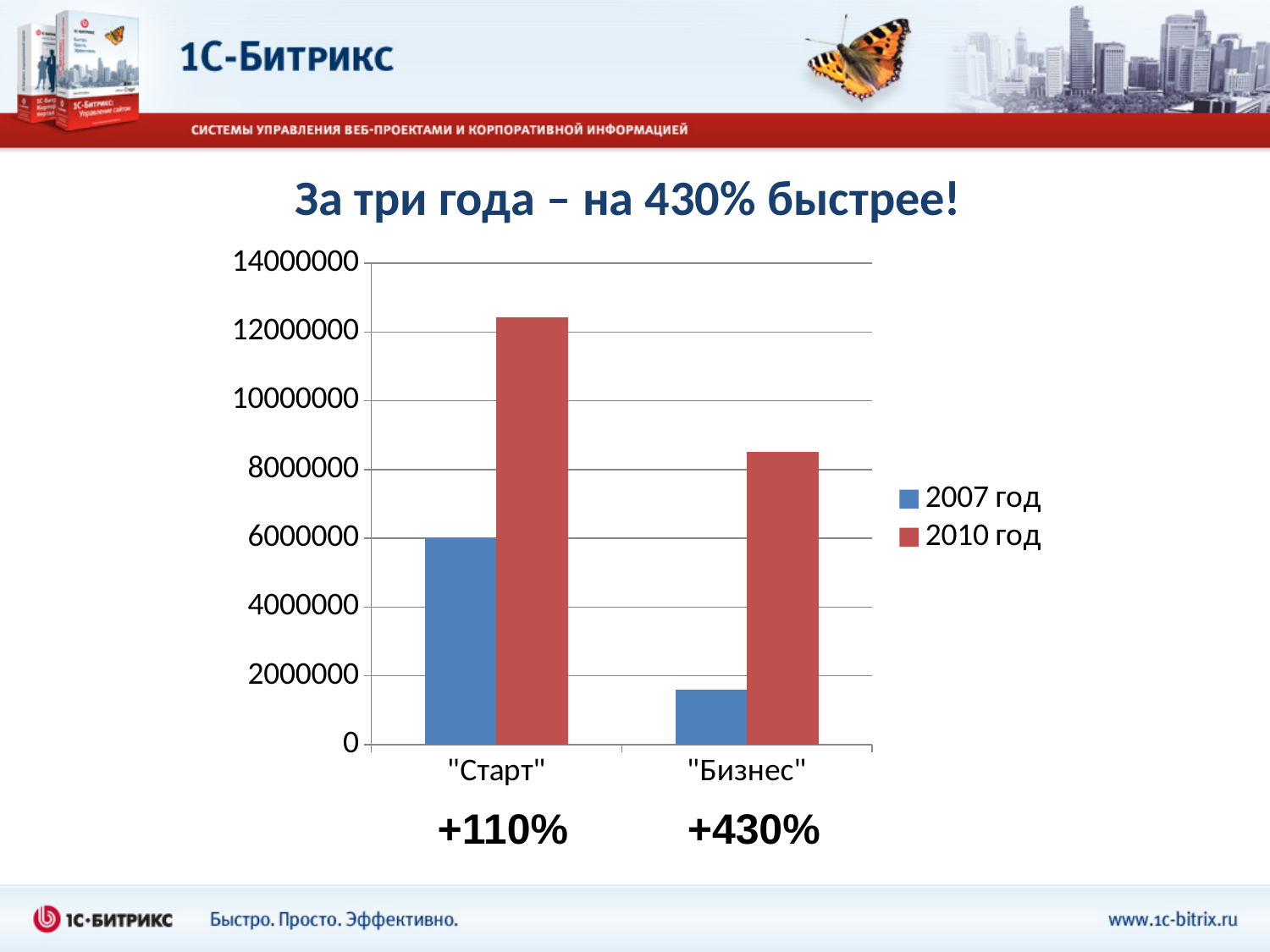
Is the 2007 год value for "Бизнес" greater or less than 2000000? less What is the title of the chart on the slide? За три года – на 430% быстрее! How many series does the legend list? 2 How many categories are shown on the x axis? 2 Which category has the lowest 2007 год bar? "Бизнес" Is the 2010 год value for "Бизнес" greater or less than 8000000? greater What kind of chart is shown on the slide? bar chart Which series does the red colour represent in the legend? 2010 год Which category has the highest 2010 год bar? "Старт" For "Бизнес", which is larger: the 2007 год bar or the 2010 год bar? 2010 год What percentage growth is printed under the "Бизнес" category? +430% Is the 2010 год value for "Старт" greater or less than 12000000? greater